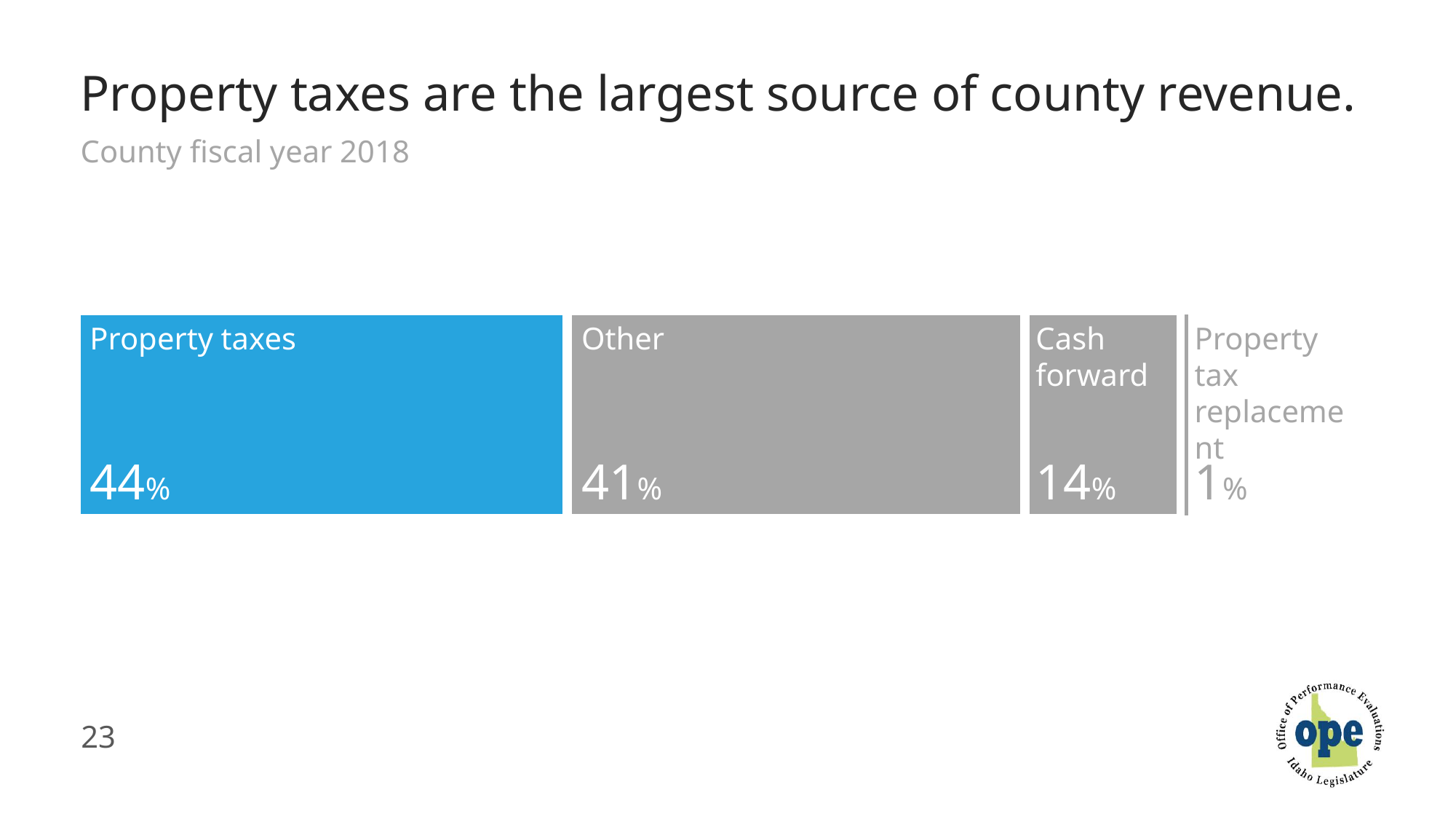
How many revenue categories are shown in the chart? 4 What share of county revenue comes from property taxes? 44% Which is larger, Cash forward or Property tax replacement? Cash forward What is the difference in percentage points between Property taxes and Other? 3 Which revenue source has the largest share? Property taxes What is the combined share of Property taxes and Other? 85% What share of county revenue is labelled Other? 41% What share of county revenue is Property tax replacement? 1% Which fiscal year does the chart cover? County fiscal year 2018 What is the difference in percentage points between Other and Cash forward? 27 What share of county revenue is Cash forward? 14% Which revenue source has the smallest share? Property tax replacement